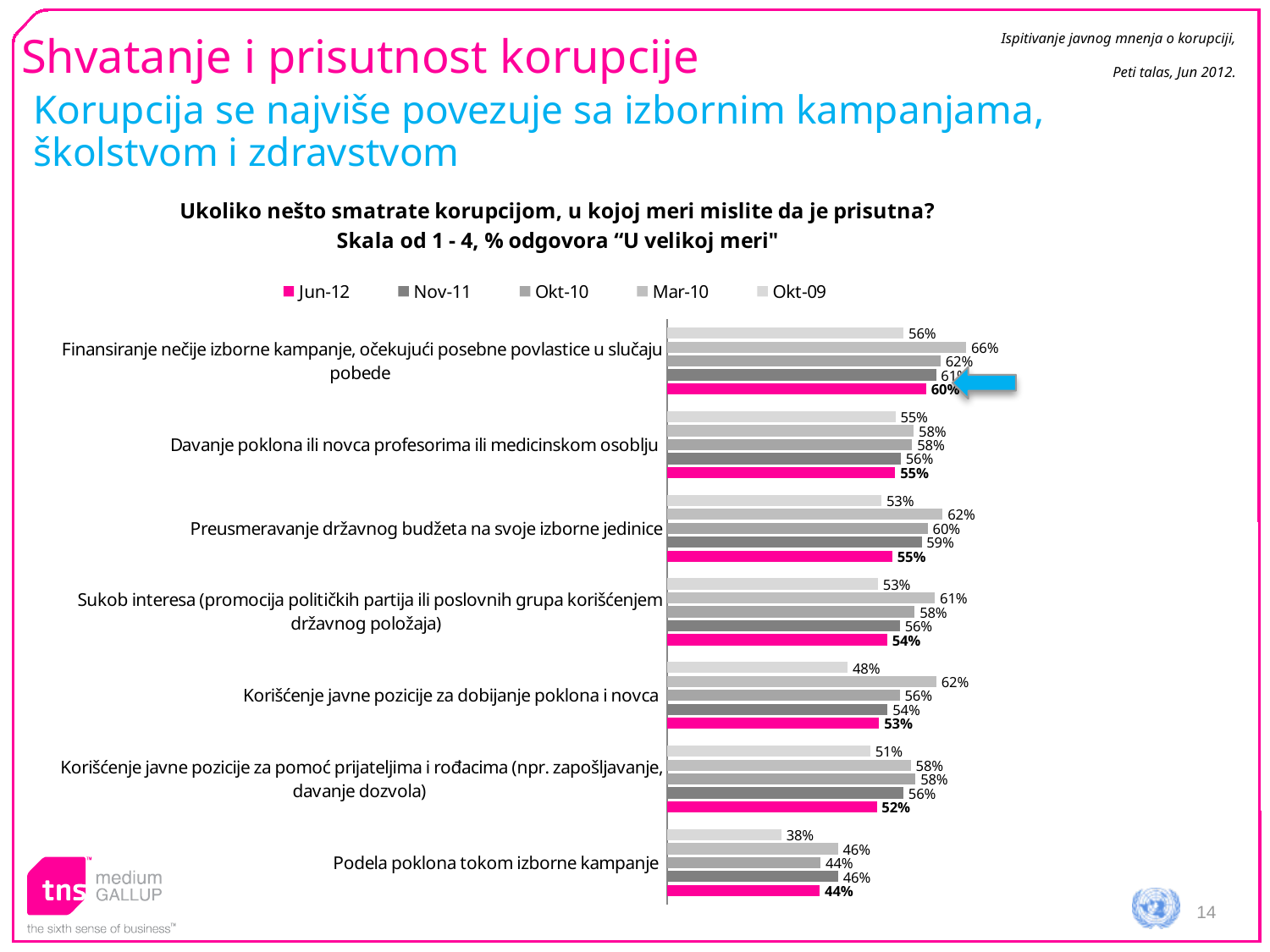
What is the Okt-09 value for 'Podela poklona tokom izborne kampanje'? 38% How many categories (statements) are shown in the chart? 7 What kind of chart is shown on the slide? bar chart What is the Okt-09 value for 'Korišćenje javne pozicije za dobijanje poklona i novca'? 48% What is the difference between the Jun-12 values for 'Finansiranje nečije izborne kampanje...' and 'Podela poklona tokom izborne kampanje'? 16 percentage points How many series does the legend list? 5 For 'Podela poklona tokom izborne kampanje', which is larger: the Jun-12 value or the Okt-09 value? Jun-12 Which series is shown in pink in the chart? Jun-12 Which category has the highest Jun-12 value? Finansiranje nečije izborne kampanje, očekujući posebne povlastice u slučaju pobede What is the Jun-12 value for 'Finansiranje nečije izborne kampanje, očekujući posebne povlastice u slučaju pobede'? 60% Which category has the lowest Jun-12 value? Podela poklona tokom izborne kampanje What is the Jun-12 value for 'Podela poklona tokom izborne kampanje'? 44%